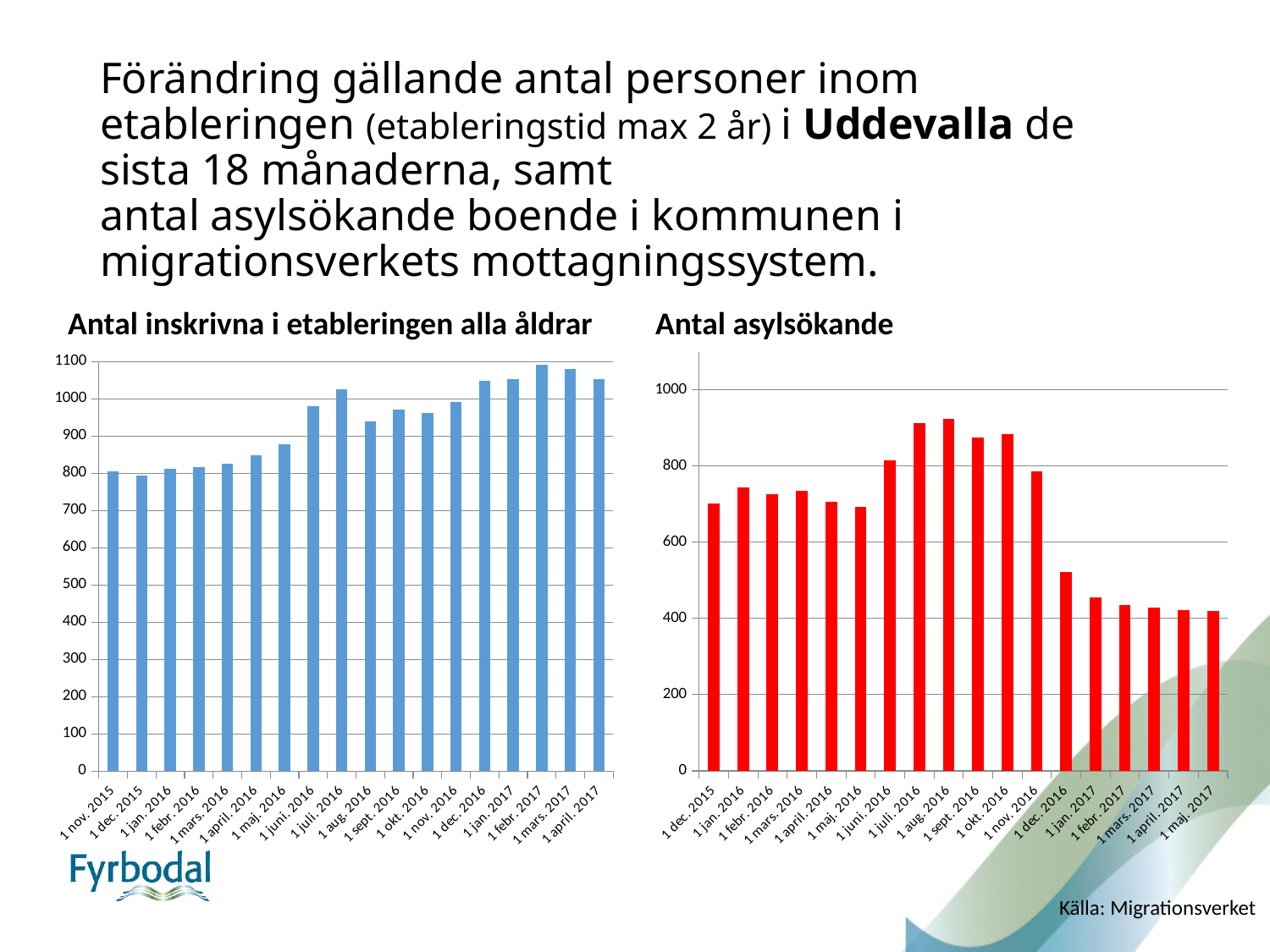
What kind of chart is the 'Antal asylsökande' chart? bar chart In the 'Antal asylsökande' chart, which is larger, the value for 1 juli 2016 or the value for 1 jan. 2017? 1 juli 2016 How many bars are plotted in the 'Antal inskrivna i etableringen alla åldrar' chart? 18 In the 'Antal inskrivna i etableringen alla åldrar' chart, is the value for 1 sept. 2016 greater or less than 1000? less How many bars are plotted in the 'Antal asylsökande' chart? 18 In the 'Antal asylsökande' chart, is the value for 1 dec. 2016 greater or less than 600? less In the 'Antal asylsökande' chart, is the value for 1 juni 2016 greater or less than 800? greater In the 'Antal inskrivna i etableringen alla åldrar' chart, do the values generally rise or fall from 1 nov. 2015 to 1 april 2017? rise What colour are the bars in the 'Antal asylsökande' chart? red In the 'Antal inskrivna i etableringen alla åldrar' chart, which is larger, the value for 1 dec. 2016 or the value for 1 dec. 2015? 1 dec. 2016